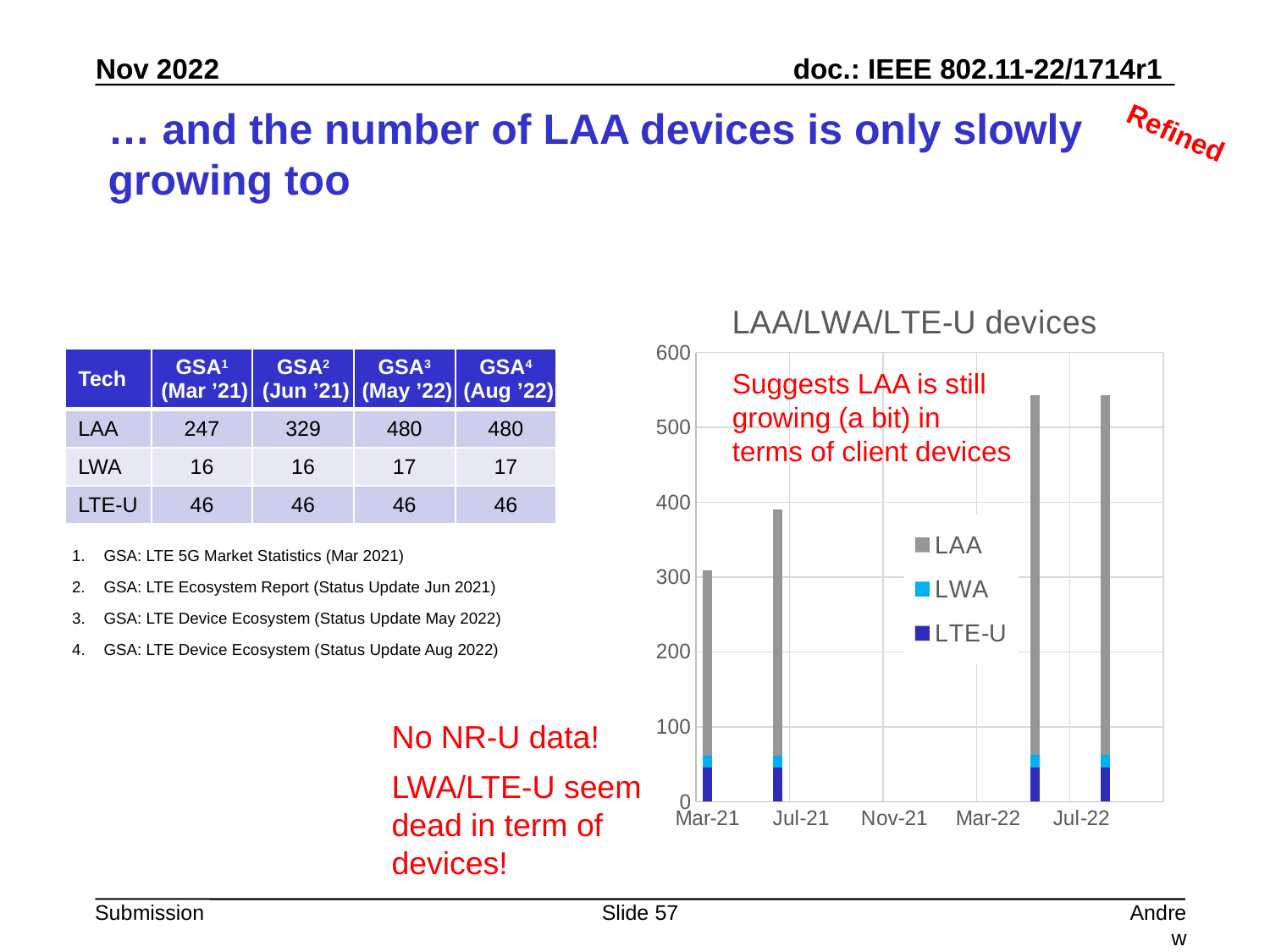
Which series are listed in the chart legend? LAA, LWA, LTE-U Which bar is taller, the first bar (Mar-21) or the second bar (mid-2021)? the second bar (mid-2021) Is the total height of the last bar greater or less than 600? less Is the total height of the first bar (Mar-21) greater or less than 200? greater Is the total height of the second bar (mid-2021) greater or less than 300? greater Do the bar totals rise or fall from left to right along the x axis? rise How many stacked bars are plotted in the chart? 4 Which bar has the lowest total in the chart? the first bar (Mar-21) What kind of chart is shown on the slide? stacked bar chart How many series does the chart legend list? 3 What is the title of the chart? LAA/LWA/LTE-U devices